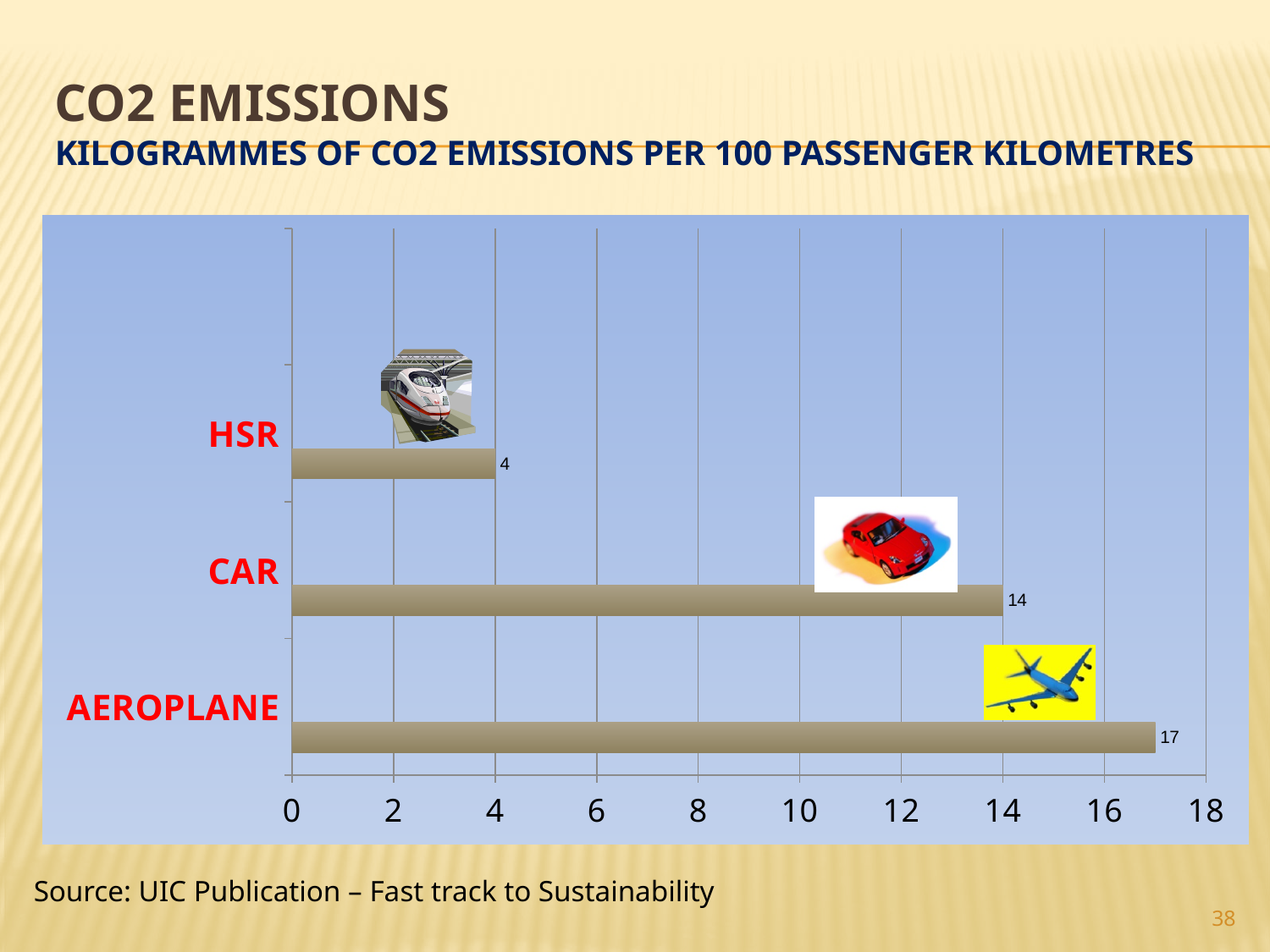
What kind of chart is shown on the slide? bar chart Which is larger, the value for CAR or the value for HSR? CAR What is the value for CAR? 14 Is the value for CAR greater or less than 10? greater What is the value for HSR? 4 What is the difference between the values for AEROPLANE and HSR? 13 Which category has the highest value? AEROPLANE How many categories are shown in the chart? 3 What is the difference between the values for AEROPLANE and CAR? 3 Which category has the lowest value? HSR What is the maximum value shown on the horizontal axis? 18 What is the value for AEROPLANE? 17